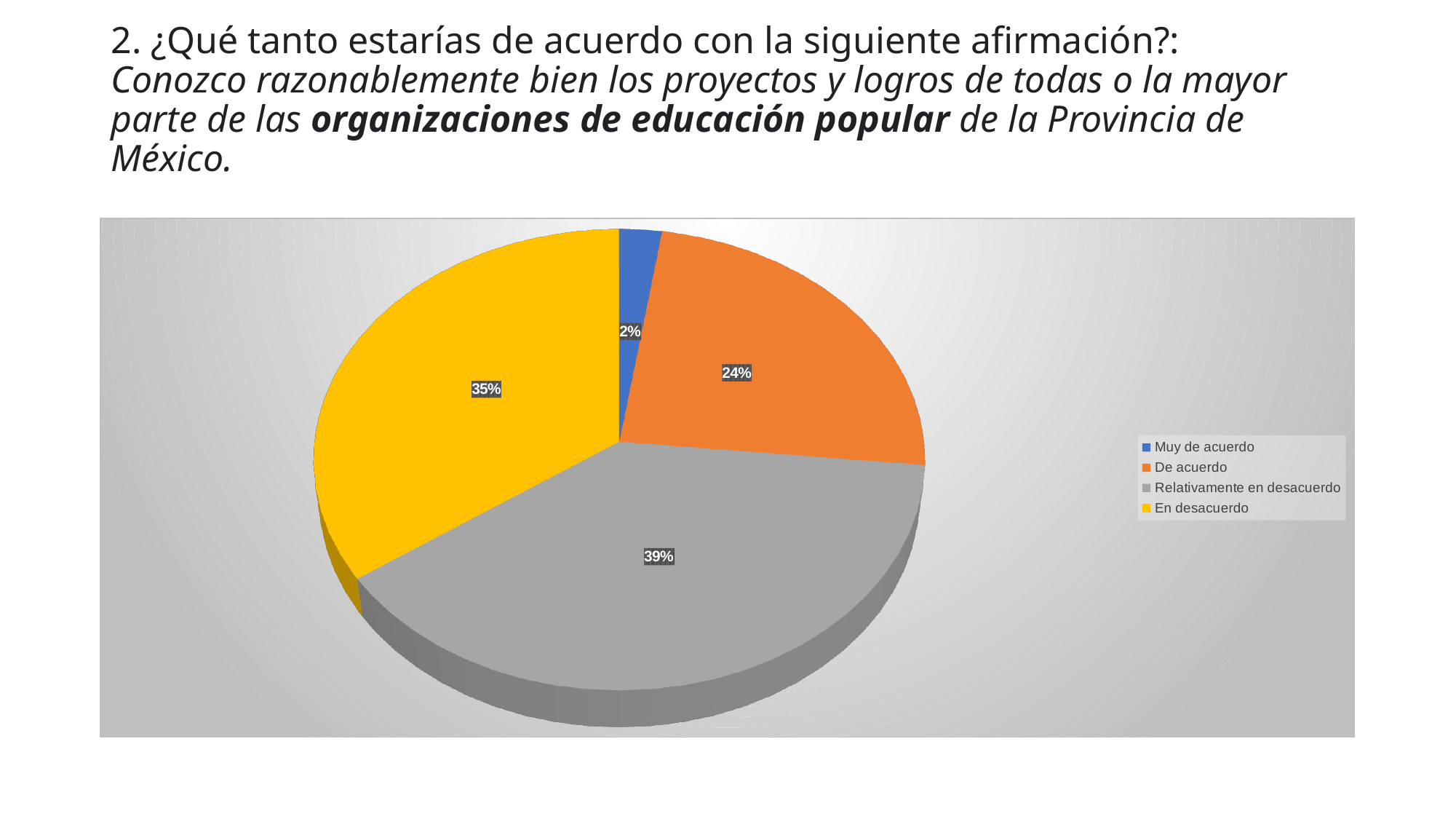
What colour is the slice for "En desacuerdo"? Yellow What share of the pie does "En desacuerdo" represent? 35% Which is larger, the slice for "En desacuerdo" or the slice for "De acuerdo"? En desacuerdo What kind of chart is shown on the slide? Pie chart Which category has the largest slice of the pie? Relativamente en desacuerdo What share of the pie does "De acuerdo" represent? 24% What share of the pie does "Muy de acuerdo" represent? 2% What is the difference in percentage points between "Relativamente en desacuerdo" and "De acuerdo"? 15 What is the difference in percentage points between "En desacuerdo" and "Muy de acuerdo"? 33 Which category has the smallest slice of the pie? Muy de acuerdo How many categories does the pie chart show? 4